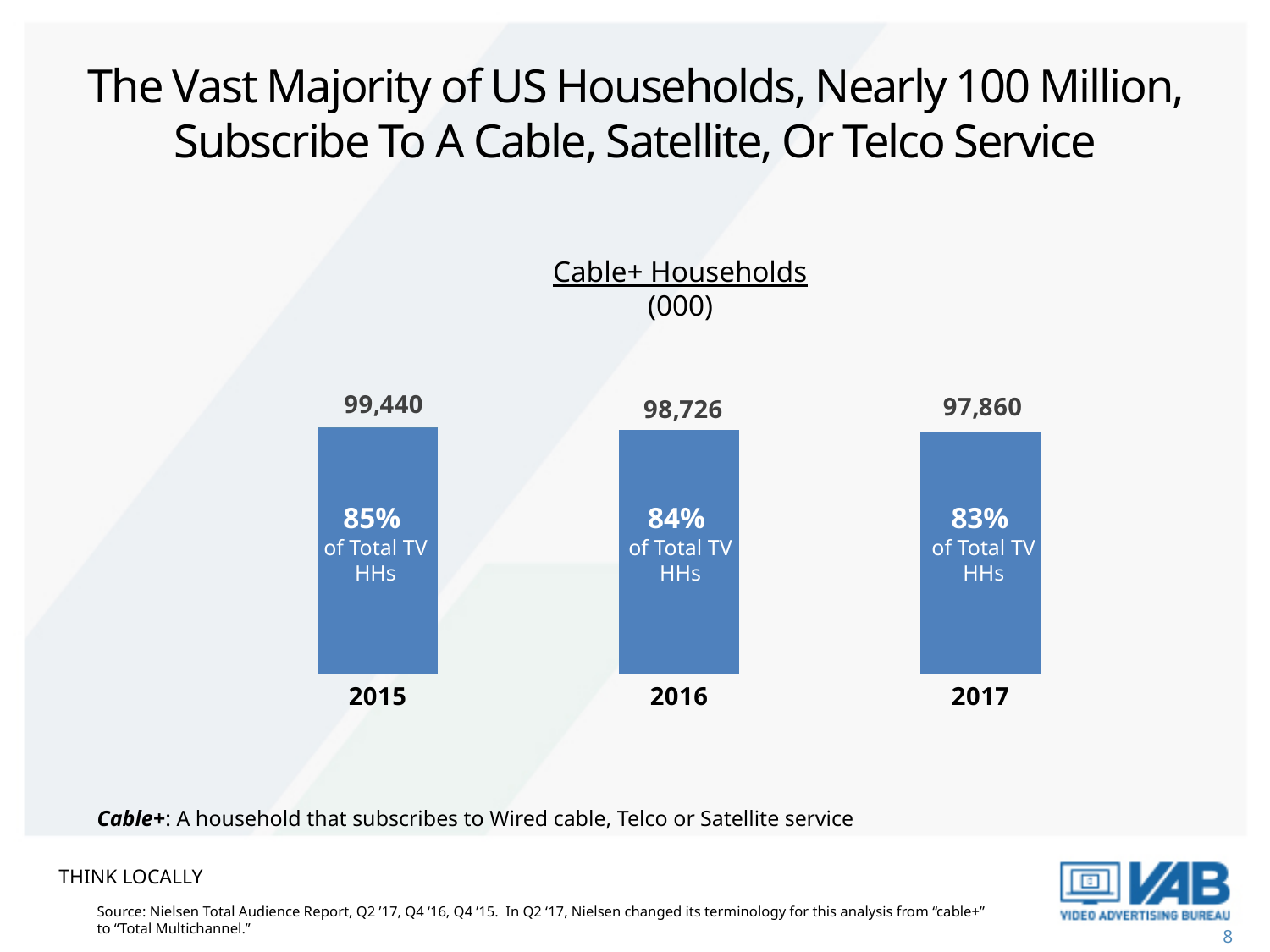
How many years are shown in the chart? 3 Which year has the highest number of Cable+ households? 2015 What is the difference in Cable+ households (000) between 2015 and 2017? 1,580 What is the number of Cable+ households (000) shown for 2017? 97,860 What kind of chart is used to show Cable+ households? Bar chart Which year has the lowest number of Cable+ households? 2017 Which year has more Cable+ households, 2016 or 2017? 2016 What percentage of total TV households were Cable+ households in 2015? 85% What is the number of Cable+ households (000) shown for 2016? 98,726 What percentage of total TV households were Cable+ households in 2017? 83% What is the difference in Cable+ households (000) between 2015 and 2016? 714 What is the number of Cable+ households (000) shown for 2015? 99,440